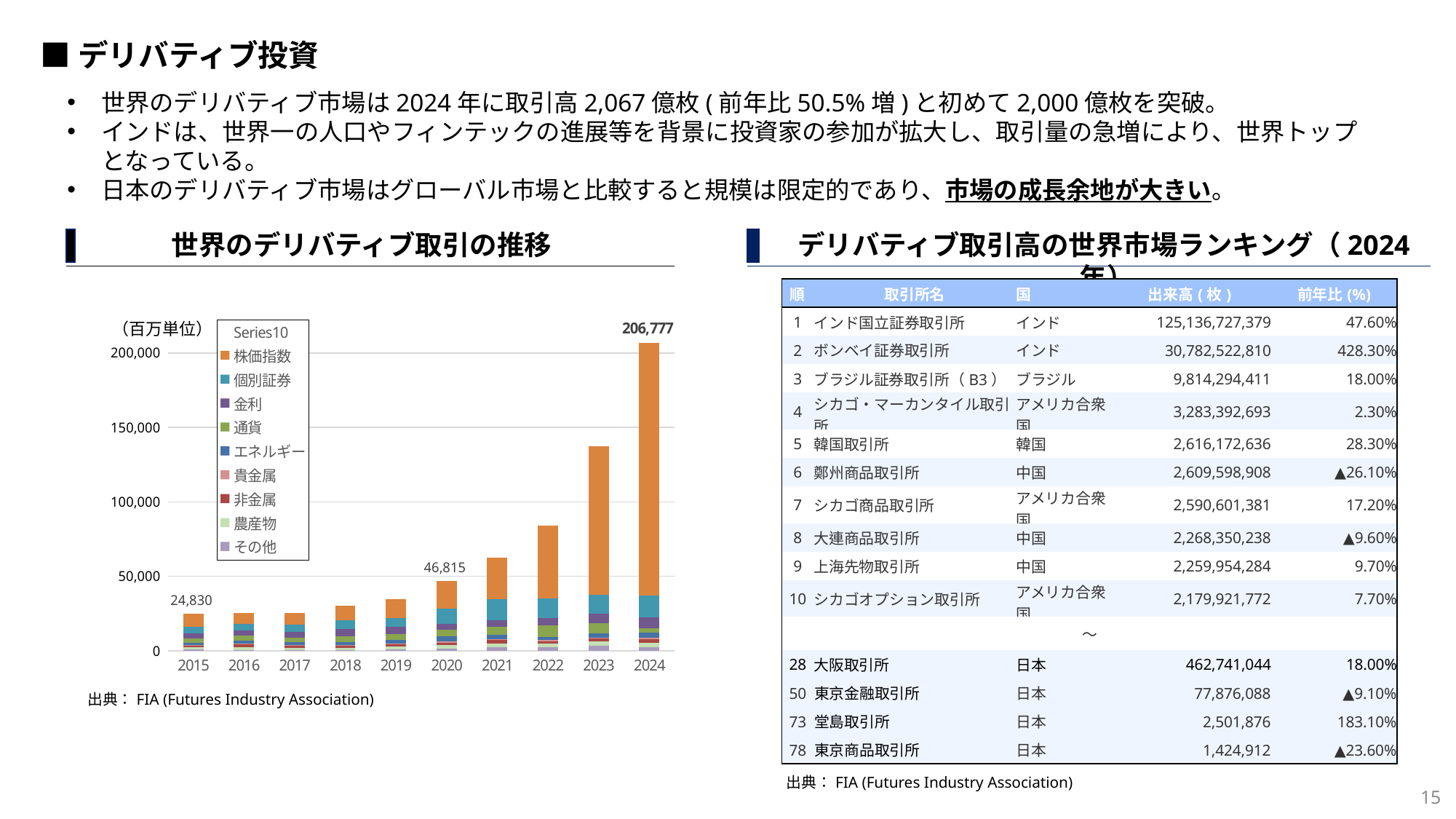
How many entries does the legend of the 世界のデリバティブ取引の推移 chart list? 10 Which year has the highest total in the 世界のデリバティブ取引の推移 chart? 2024 What is the total value labelled for 2020 in the 世界のデリバティブ取引の推移 chart? 46,815 What kind of chart is shown under the title 世界のデリバティブ取引の推移? Stacked bar chart In the 世界のデリバティブ取引の推移 chart, what is the difference between the labelled totals for 2024 and 2015? 181,947 What is the total value labelled for 2024 in the 世界のデリバティブ取引の推移 chart? 206,777 In the 世界のデリバティブ取引の推移 chart, is the total for 2023 greater or less than 100,000? greater In the 世界のデリバティブ取引の推移 chart, what is the difference between the labelled totals for 2020 and 2015? 21,985 Do the totals in the 世界のデリバティブ取引の推移 chart generally rise or fall from 2015 to 2024? Rise What is the total value labelled for 2015 in the 世界のデリバティブ取引の推移 chart? 24,830 How many years are shown on the x axis of the 世界のデリバティブ取引の推移 chart? 10 In the 世界のデリバティブ取引の推移 chart, is the total for 2022 greater or less than 100,000? less